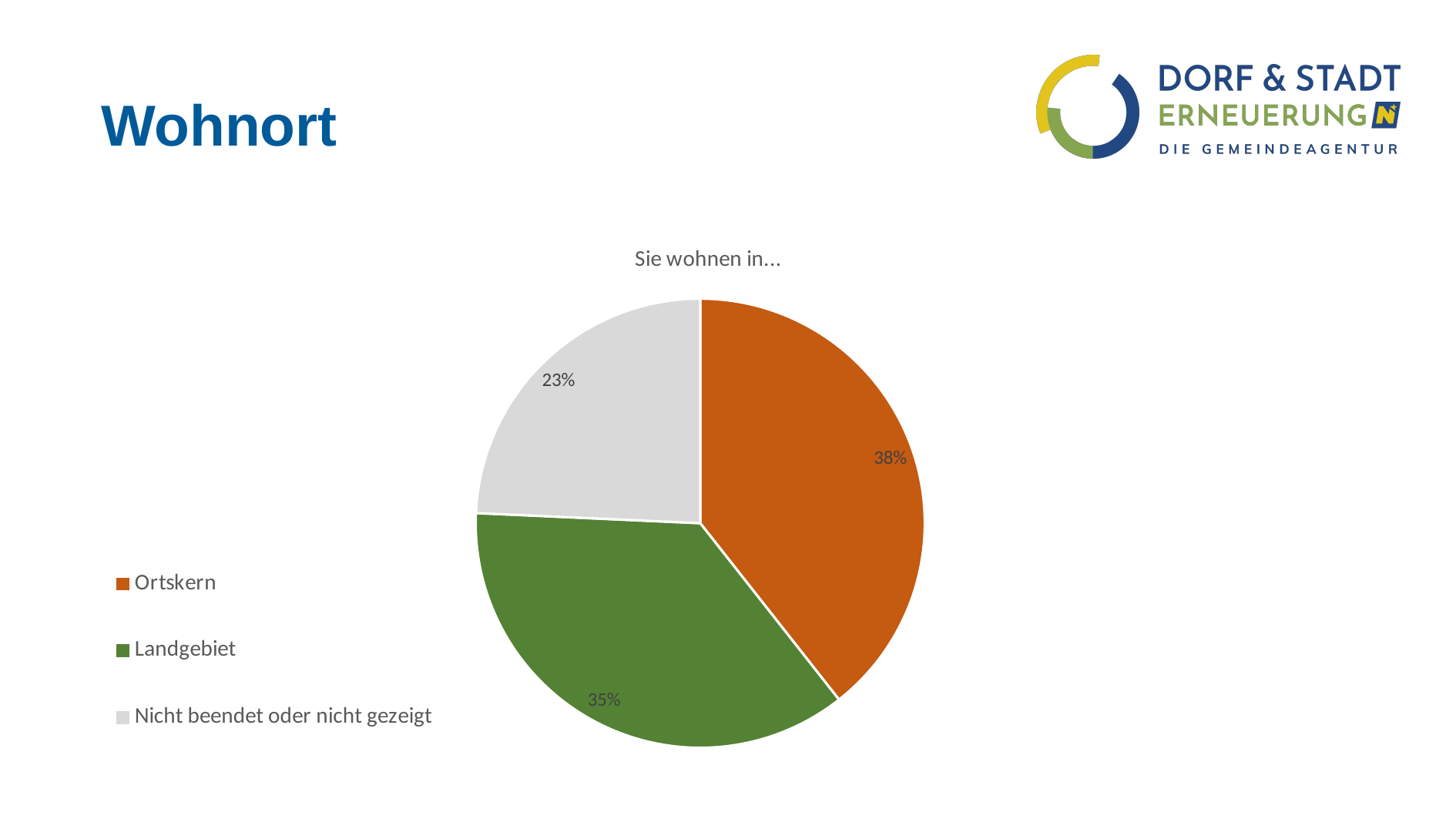
What is the difference in percentage points between Landgebiet and Nicht beendet oder nicht gezeigt? 12 What kind of chart is shown on the slide? pie chart What share of the pie is Nicht beendet oder nicht gezeigt? 23% How many categories does the pie chart have? 3 What share of the pie is Ortskern? 38% Which category has the largest slice? Ortskern What is the difference in percentage points between Ortskern and Landgebiet? 3 What share of the pie is Landgebiet? 35% Which category has the smallest slice? Nicht beendet oder nicht gezeigt Which is larger, the share for Landgebiet or the share for Nicht beendet oder nicht gezeigt? Landgebiet What colour is the Landgebiet slice? green What is the title of the chart? Sie wohnen in…